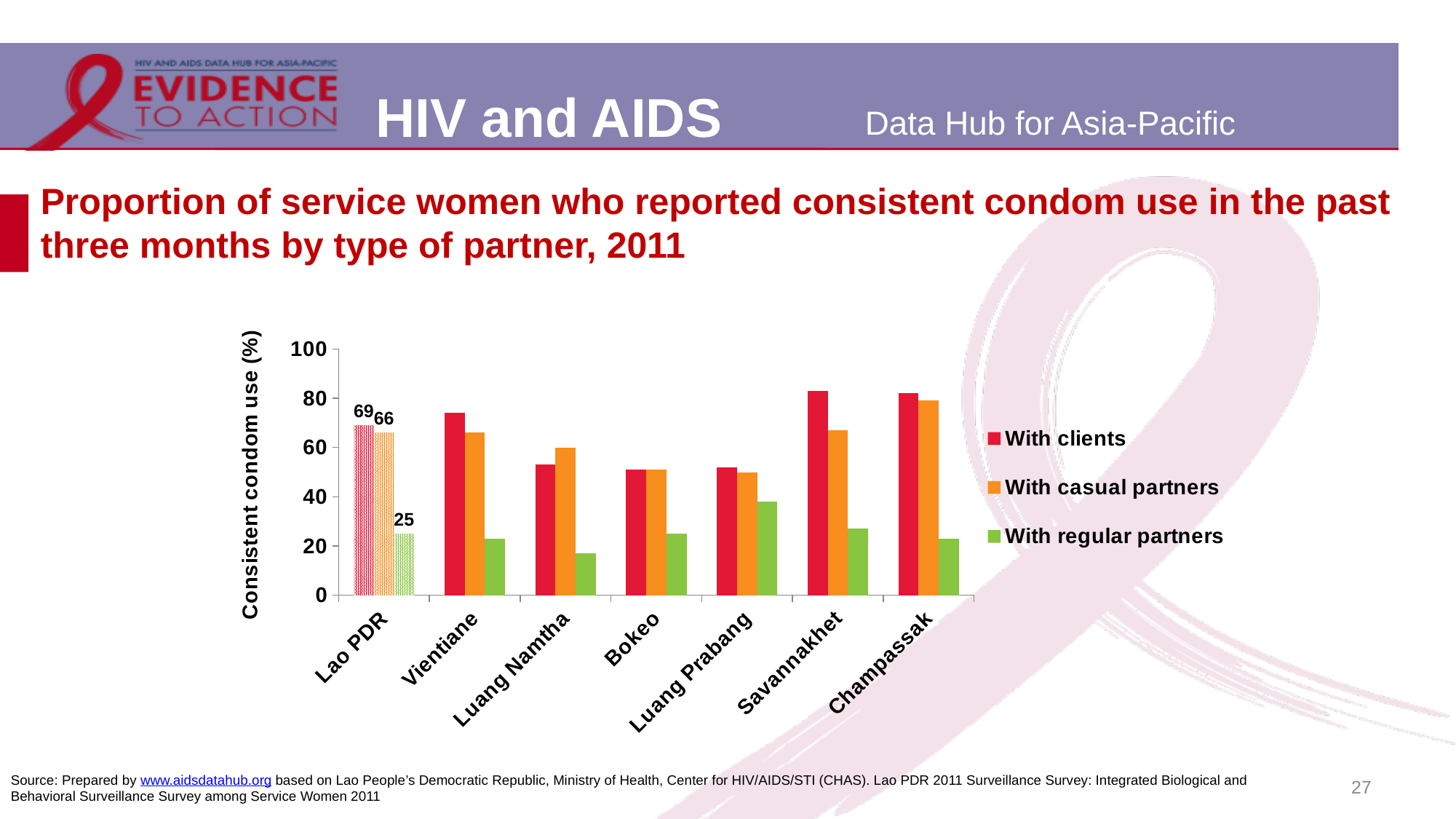
What is the value for Lao PDR in the 'With clients' series? 69 Is the 'With regular partners' value for Luang Namtha greater or less than 20? less Which location has the highest 'With regular partners' value? Luang Prabang For Lao PDR, what is the difference between the 'With clients' value and the 'With regular partners' value? 44 What is the value for Lao PDR in the 'With regular partners' series? 25 What kind of chart is shown on the slide? Bar chart What is the value for Lao PDR in the 'With casual partners' series? 66 For Lao PDR, which is larger: the 'With clients' value or the 'With casual partners' value? With clients Which location has the lowest 'With regular partners' value? Luang Namtha How many series does the legend list? 3 Is the 'With clients' value for Savannakhet greater or less than 80? greater How many locations are shown on the x axis? 7